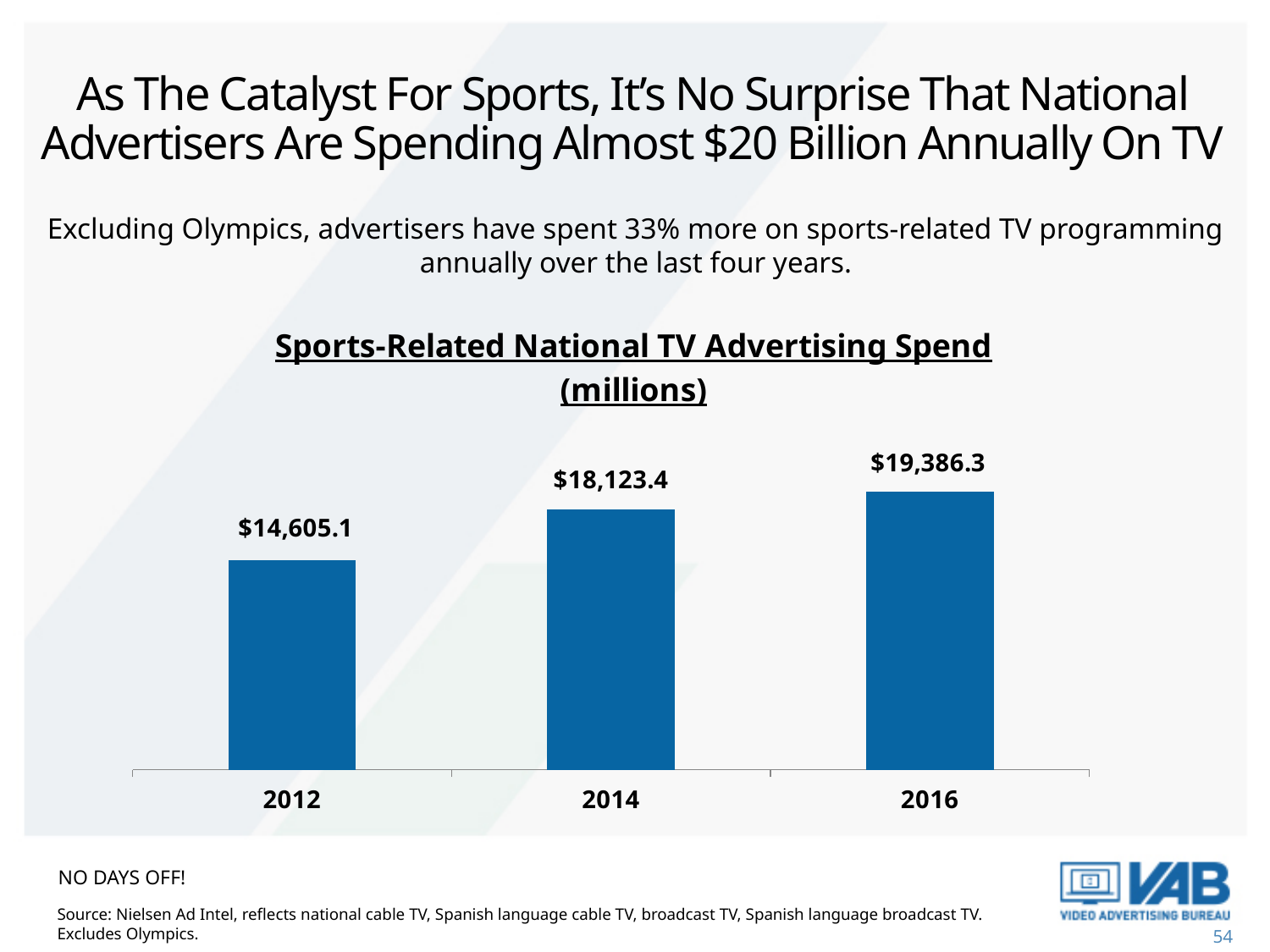
What is the difference in advertising spend between 2016 and 2012? $4,781.2 What is the title of the chart? Sports-Related National TV Advertising Spend (millions) What kind of chart is shown on the slide? Bar chart Which year has a larger advertising spend, 2014 or 2016? 2016 Which year has the lowest sports-related national TV advertising spend? 2012 How many years are shown in the chart? 3 What is the sports-related national TV advertising spend for 2014? $18,123.4 Which year has the highest sports-related national TV advertising spend? 2016 What is the sports-related national TV advertising spend for 2016? $19,386.3 What is the sports-related national TV advertising spend for 2012? $14,605.1 What is the difference in advertising spend between 2014 and 2012? $3,518.3 Do the advertising spend values rise or fall from 2012 to 2016? Rise